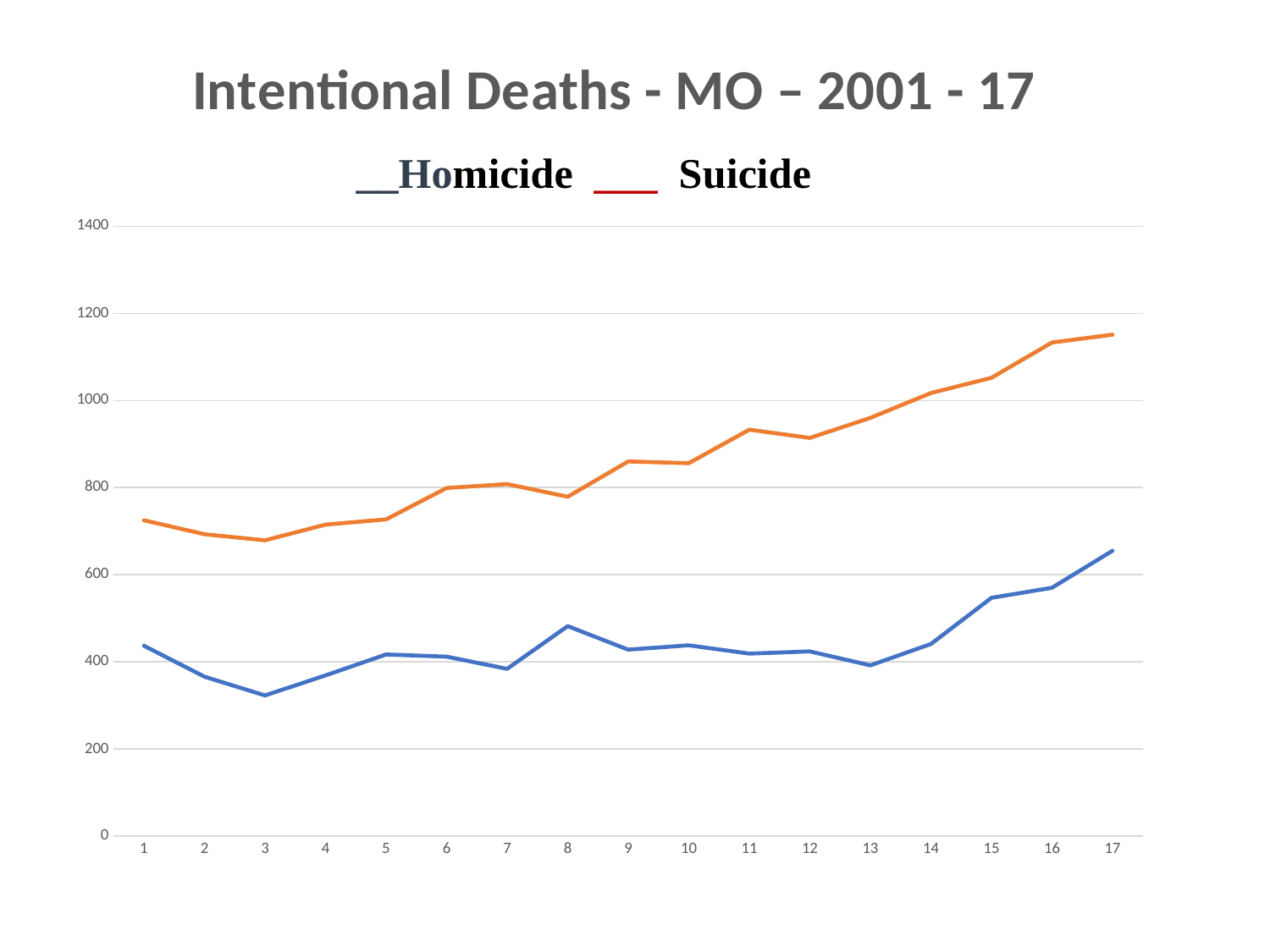
What is the title of the chart? Intentional Deaths - MO – 2001 - 17 Does the Suicide series generally rise or fall from point 1 to point 17? rise Is the Homicide value at point 3 greater or less than 400? less At point 10, which series has the larger value, Homicide or Suicide? Suicide At which x-axis point is the Suicide series highest? 17 Is the Suicide value at point 17 greater or less than 1000? greater Which series is drawn in orange? Suicide How many series does the legend list? 2 Is the Suicide value at point 12 greater or less than 800? greater How many points are plotted along the x axis for each series? 17 What kind of chart is shown on the slide? line chart At which x-axis point is the Homicide series lowest? 3